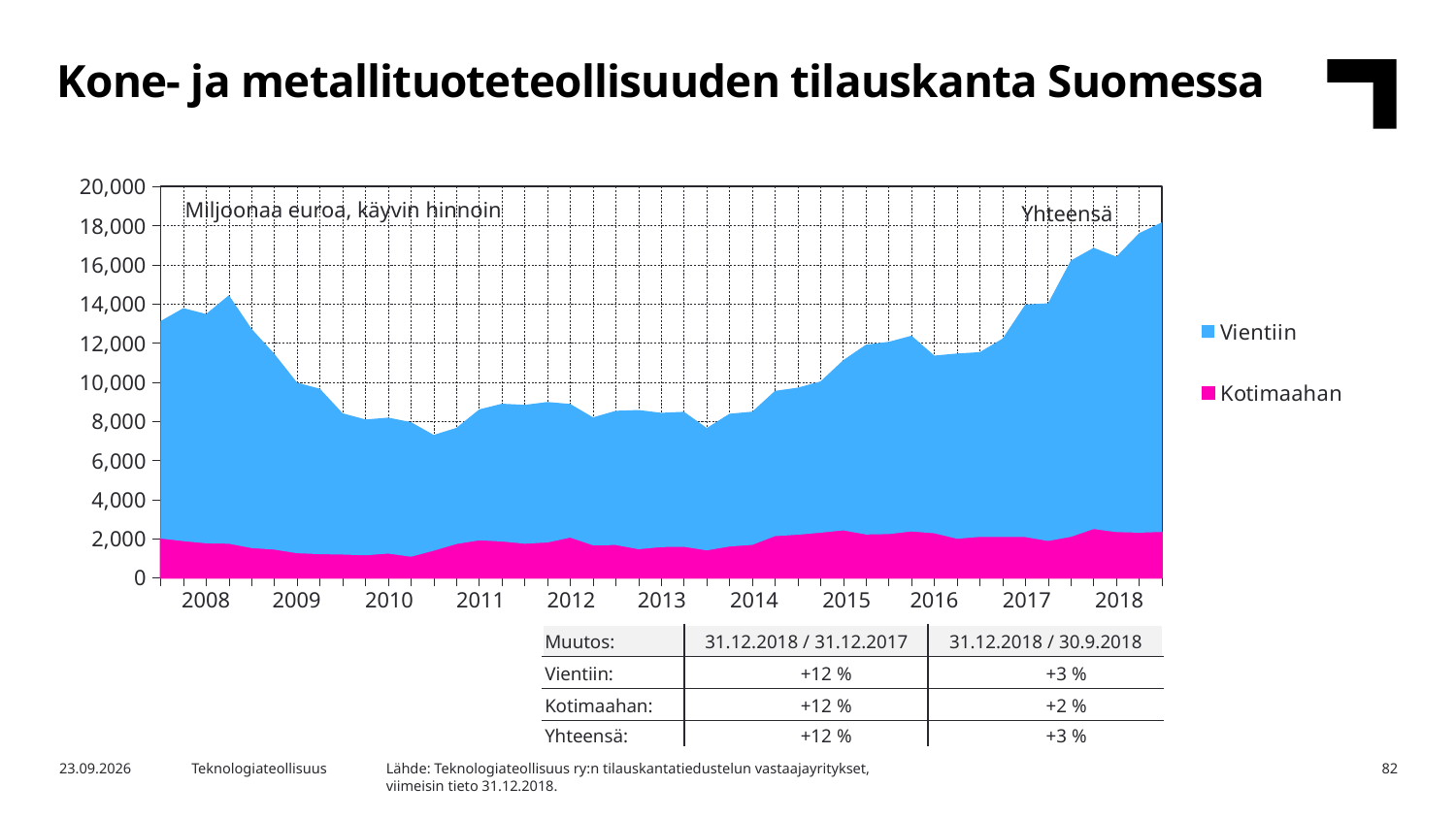
What is the title of the slide containing the chart? Kone- ja metallituoteteollisuuden tilauskanta Suomessa Which series is larger throughout the chart, Vientiin or Kotimaahan? Vientiin Is the total (Yhteensä) value during 2013 greater or less than 10,000? less What type of chart is shown on the slide? Stacked area chart Is the Kotimaahan value in 2018 greater or less than 4,000? less Does the total (Yhteensä) value rise or fall from 2014 to 2018? rise According to the table below the chart, what is the change in Vientiin between 31.12.2017 and 31.12.2018? +12 % Is the total (Yhteensä) value at the end of 2018 greater or less than 16,000? greater Is the total order backlog higher in 2018 or in 2013? 2018 How many years are labelled on the x axis of the chart? 11 Which two series are listed in the chart legend? Vientiin and Kotimaahan How many series does the chart legend list? 2